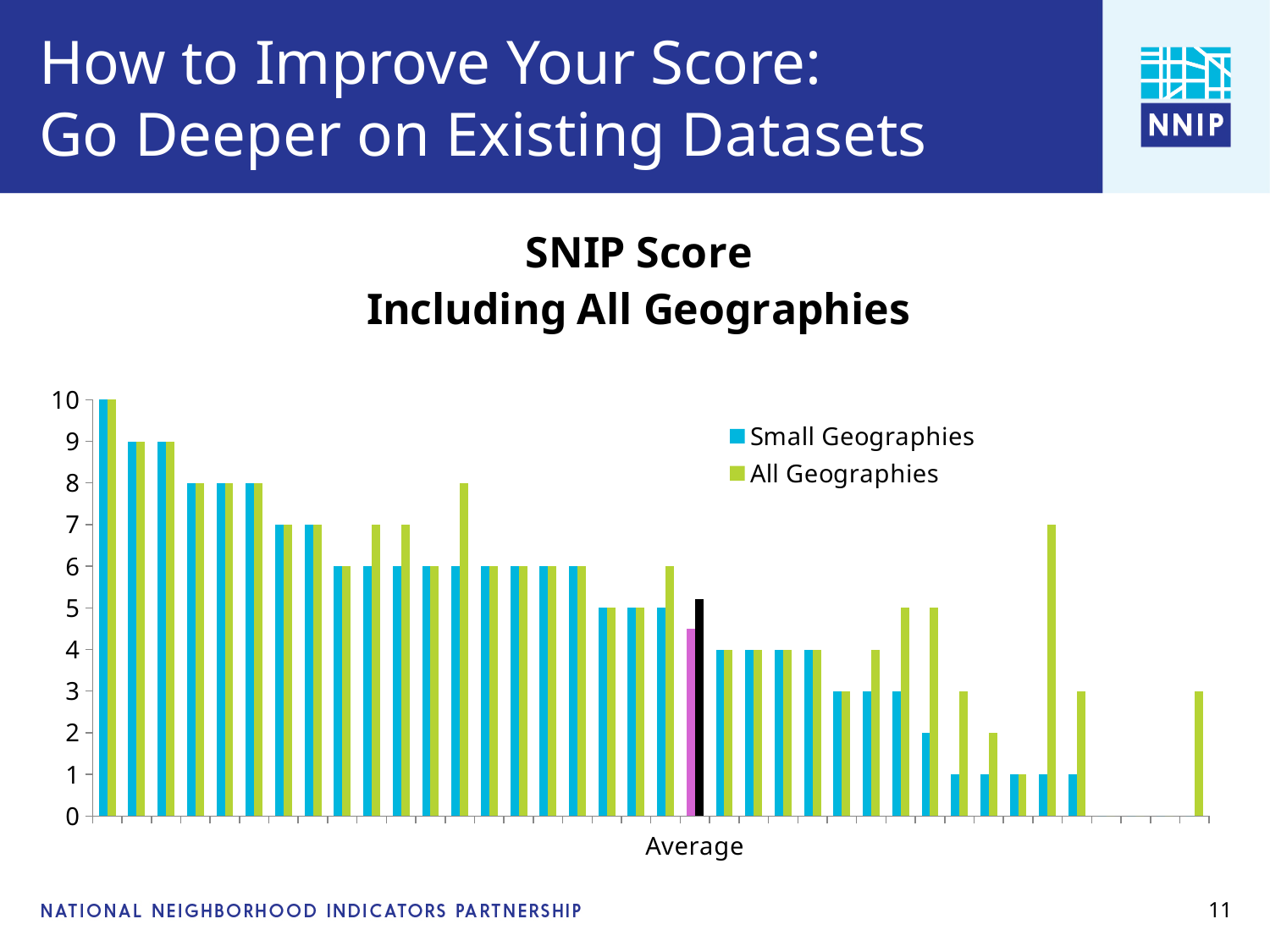
Is the Small Geographies value for Average greater or less than 5? less For the Average category, which series has the larger value, Small Geographies or All Geographies? All Geographies Do the scores generally rise or fall moving from left to right along the x axis? fall How many series does the legend list? 2 What are the two series named in the legend? Small Geographies and All Geographies What is the title of the chart? SNIP Score Including All Geographies Which category label is printed on the x axis? Average Is the All Geographies value for Average greater or less than 4? greater What is the highest score reached by any bar on the chart? 10 What kind of chart is shown on the slide? bar chart What is the maximum value shown on the y axis? 10